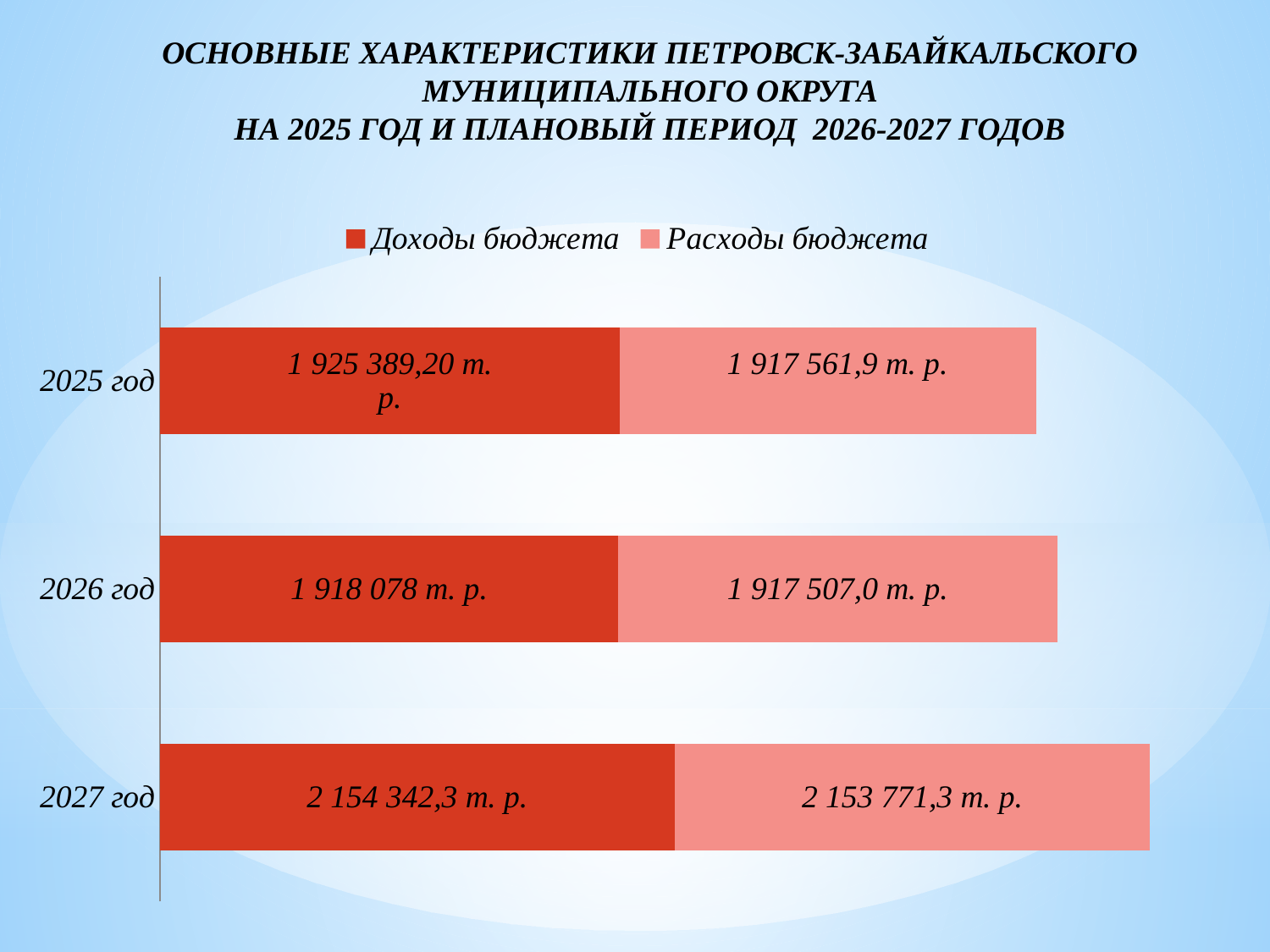
Which is larger: Доходы бюджета for 2027 год or Доходы бюджета for 2025 год? Доходы бюджета for 2027 год What is the value of Доходы бюджета for 2025 год? 1 925 389,20 т. р. What is the value of Доходы бюджета for 2026 год? 1 918 078 т. р. What is the difference between Доходы бюджета and Расходы бюджета for 2027 год? 571,0 т. р. What is the value of Расходы бюджета for 2026 год? 1 917 507,0 т. р. What is the difference between Доходы бюджета and Расходы бюджета for 2025 год? 7 827,3 т. р. Which year has the highest value of Доходы бюджета? 2027 год What is the value of Расходы бюджета for 2027 год? 2 153 771,3 т. р. How many years are shown on the chart? 3 How many series does the legend list? 2 What kind of chart is shown on the slide? Stacked bar chart